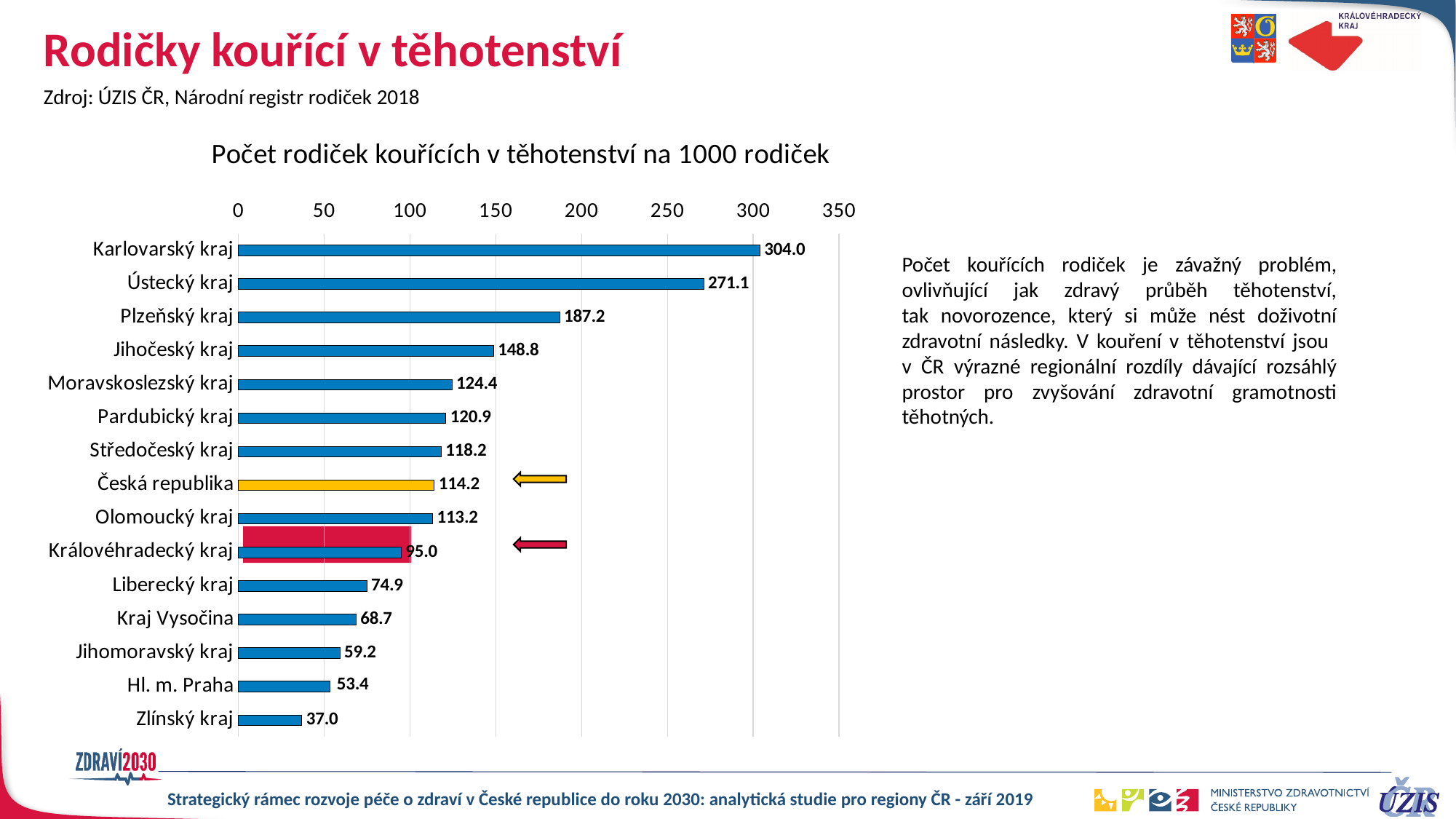
How many categories are shown in the chart? 15 What kind of chart is shown on the slide? Bar chart What is the value for Královéhradecký kraj? 95.0 Which has a larger value, Plzeňský kraj or Jihočeský kraj? Plzeňský kraj What is the value for Karlovarský kraj? 304.0 What is the value for Hl. m. Praha? 53.4 What is the difference between the values for Karlovarský kraj and Ústecký kraj? 32.9 What is the value for Česká republika? 114.2 Which category has the lowest value? Zlínský kraj Which category has the highest value? Karlovarský kraj What is the title of the chart? Počet rodiček kouřících v těhotenství na 1000 rodiček What is the difference between the values for Česká republika and Královéhradecký kraj? 19.2